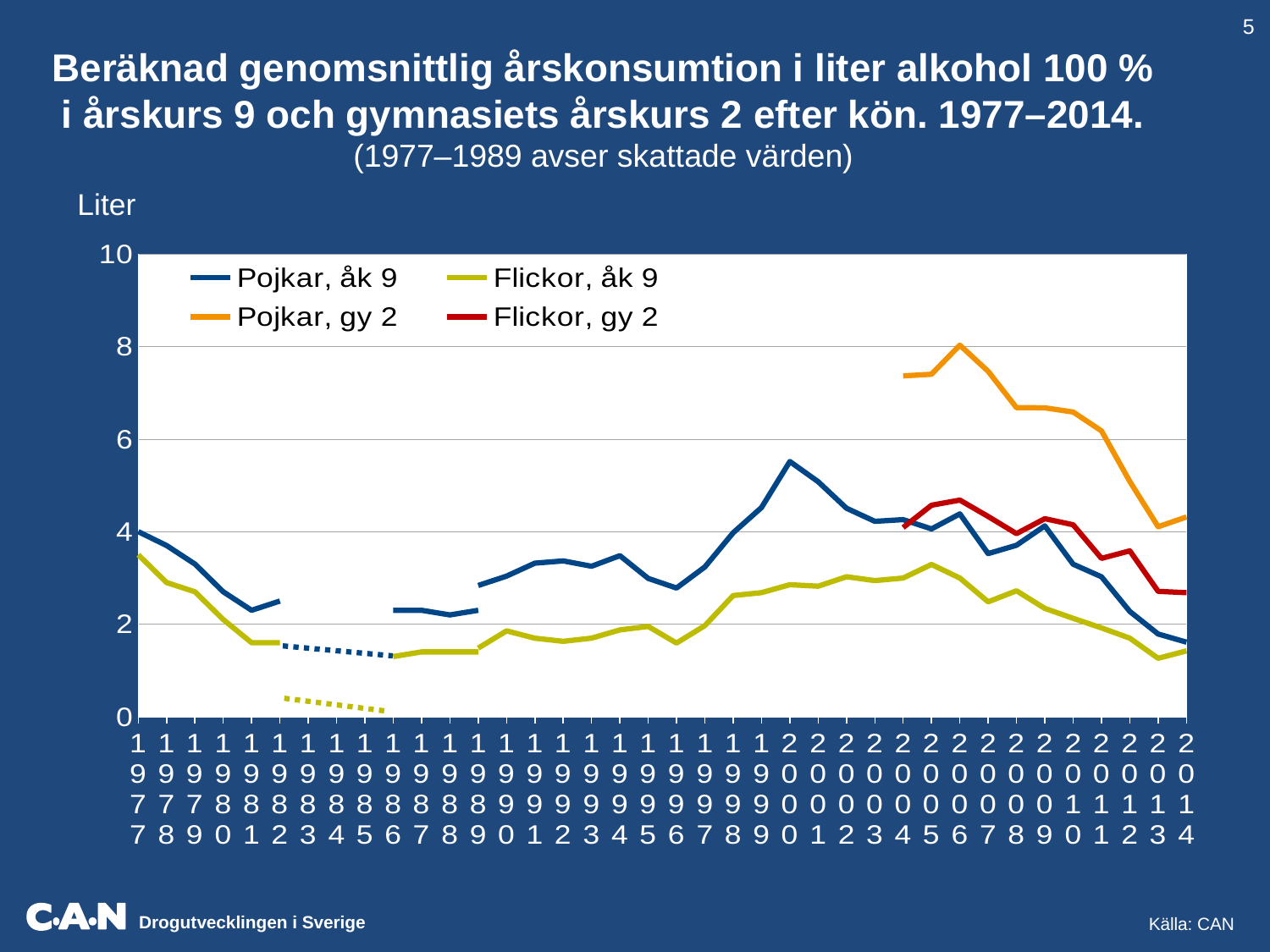
How many years are shown along the x axis (1977 to 2014)? 38 Does the Pojkar, gy 2 line rise or fall from 2006 to 2013? fall Is the value for Pojkar, gy 2 in 2006 greater or less than 6? greater Is the value for Flickor, åk 9 in 2013 greater or less than 2? less Which series reaches the highest value anywhere on the chart? Pojkar, gy 2 What are the four series named in the legend? Pojkar, åk 9; Flickor, åk 9; Pojkar, gy 2; Flickor, gy 2 Is the value for Pojkar, åk 9 in 2000 greater or less than 4? greater What kind of chart is shown on the slide? line chart What unit label is shown above the y axis? Liter How many series does the legend list? 4 In 2006, which is higher: Pojkar, gy 2 or Flickor, gy 2? Pojkar, gy 2